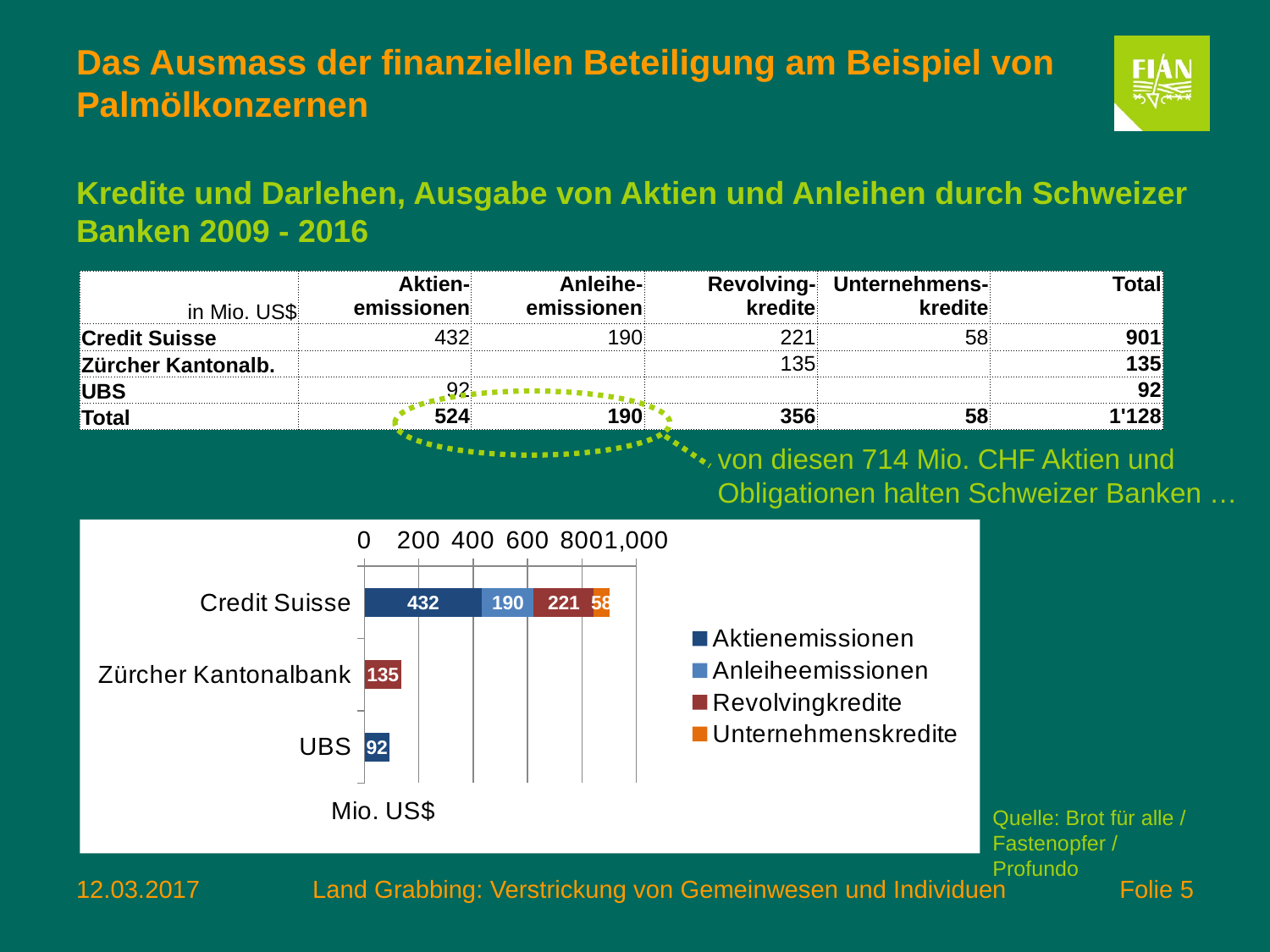
How many series does the chart legend list? 4 What is the Revolvingkredite value for Zürcher Kantonalbank in the chart? 135 What unit label is shown below the chart's x axis? Mio. US$ What is the difference between the Aktienemissionen values for Credit Suisse and UBS in the chart? 340 What kind of chart is shown on the slide? Stacked bar chart What is the total of the stacked bar for Credit Suisse in the chart? 901 What is the Aktienemissionen value for Credit Suisse in the chart? 432 How many banks are shown as categories in the chart? 3 Which bank has the longest bar in the chart? Credit Suisse What is the Unternehmenskredite value for Credit Suisse in the chart? 58 Which bank has the shortest bar in the chart? UBS What is the Aktienemissionen value for UBS in the chart? 92